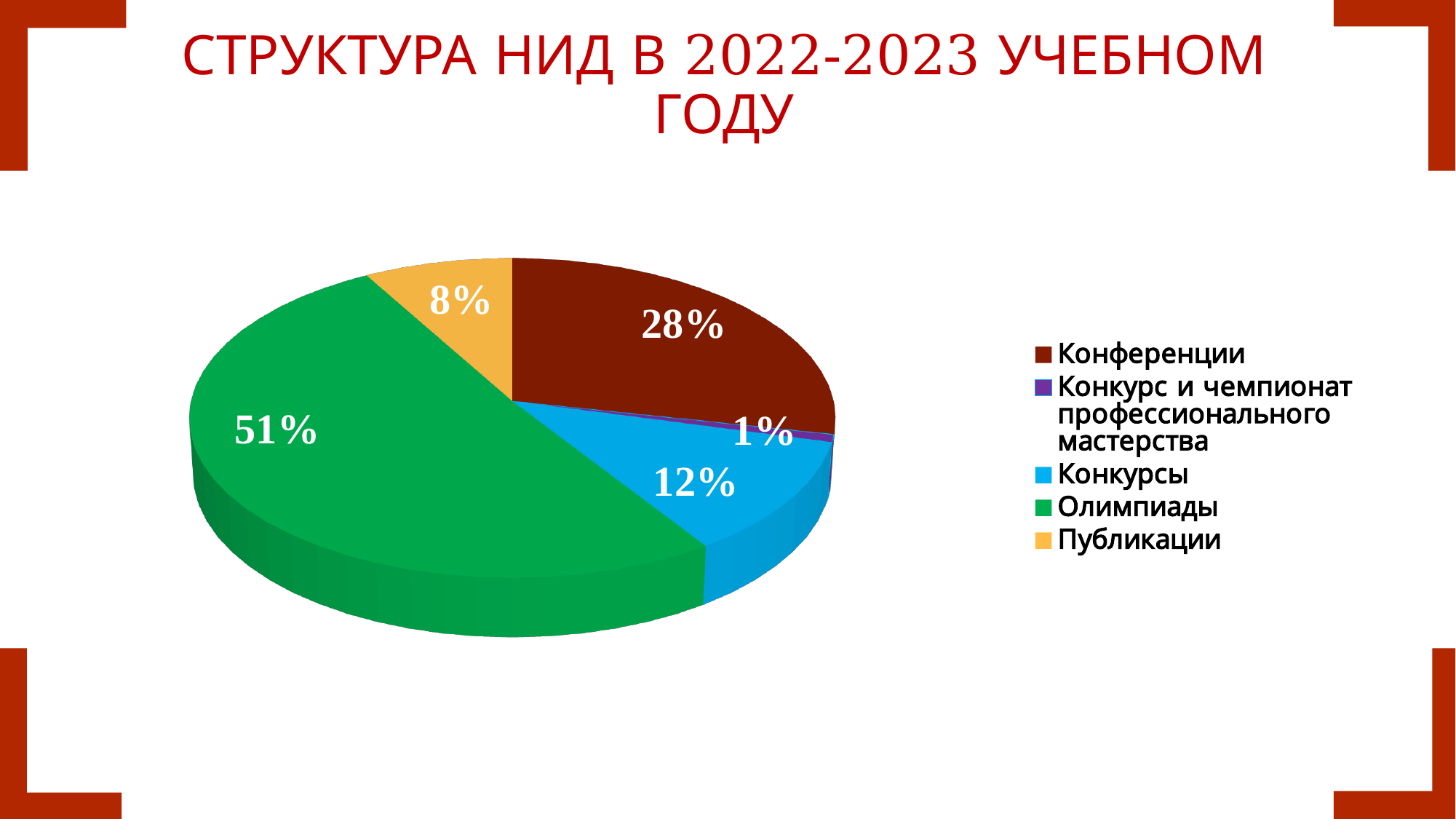
How many categories does the pie chart show? 5 Which category has the smallest slice of the pie? Конкурс и чемпионат профессионального мастерства Which category has the largest slice of the pie? Олимпиады What kind of chart is shown on the slide? Pie chart What colour is the slice for Олимпиады? Green What share of the pie does Конкурсы have? 12% What share of the pie does Олимпиады have? 51% What share of the pie does Публикации have? 8% What is the difference in percentage points between Олимпиады and Конференции? 23 Which is larger, the share for Конкурсы or the share for Публикации? Конкурсы